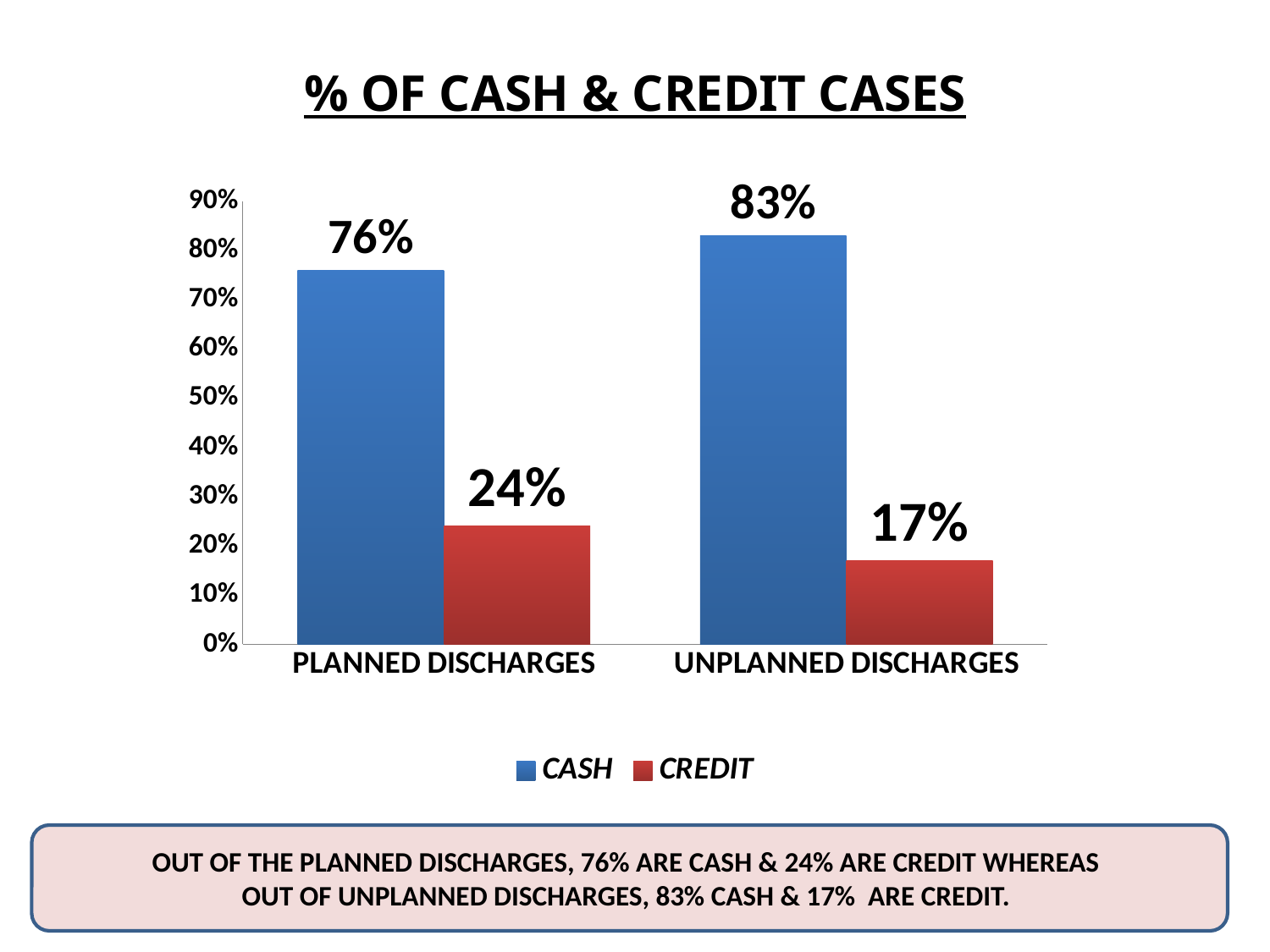
Which category has the highest CASH value? UNPLANNED DISCHARGES What is the CREDIT value for PLANNED DISCHARGES? 24% Is the CASH value for UNPLANNED DISCHARGES greater or less than 80%? greater What is the CASH value for PLANNED DISCHARGES? 76% What kind of chart is shown on the slide? bar chart Which category has the lowest CREDIT value? UNPLANNED DISCHARGES How many categories are shown on the x axis? 2 How many series does the legend list? 2 Which is larger: the CREDIT value for PLANNED DISCHARGES or the CREDIT value for UNPLANNED DISCHARGES? PLANNED DISCHARGES What is the difference between the CASH values for UNPLANNED DISCHARGES and PLANNED DISCHARGES? 7% What is the CREDIT value for UNPLANNED DISCHARGES? 17% What is the difference between the CASH and CREDIT values for PLANNED DISCHARGES? 52%